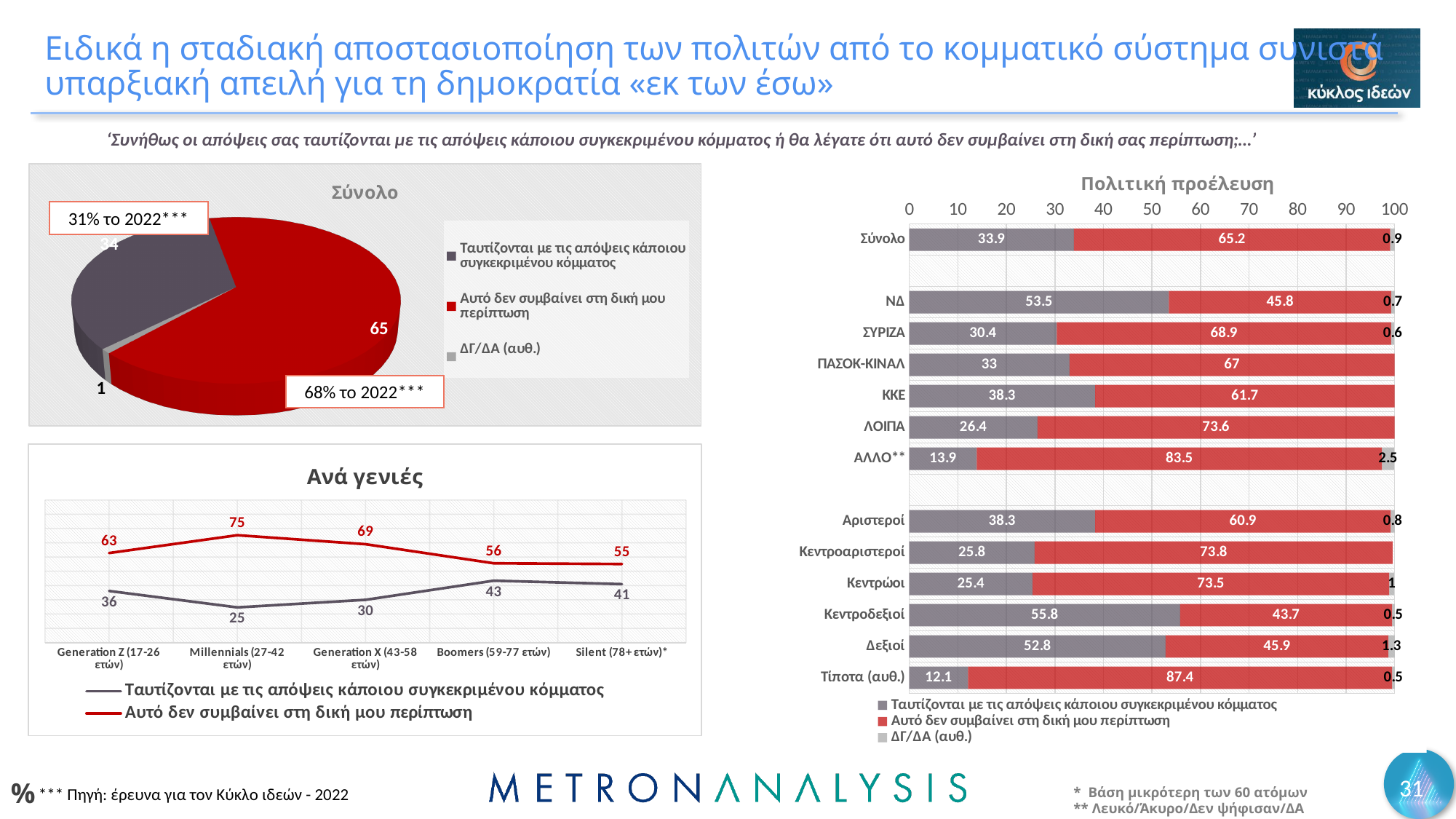
In the 'Ανά γενιές' chart, which generation has the lowest value for 'Ταυτίζονται με τις απόψεις κάποιου συγκεκριμένου κόμματος'? Millennials (27-42 ετών) What kind of chart is the 'Σύνολο' chart? pie chart How many series does the legend of the 'Πολιτική προέλευση' chart list? 3 In the 'Πολιτική προέλευση' chart, what is the value of 'Ταυτίζονται με τις απόψεις κάποιου συγκεκριμένου κόμματος' for ΝΔ? 53.5 What kind of chart is the 'Πολιτική προέλευση' chart? stacked bar chart In the 'Πολιτική προέλευση' chart, which is larger for ΚΚΕ: 'Ταυτίζονται με τις απόψεις κάποιου συγκεκριμένου κόμματος' or 'Αυτό δεν συμβαίνει στη δική μου περίπτωση'? Αυτό δεν συμβαίνει στη δική μου περίπτωση How many generation categories are shown on the x axis of the 'Ανά γενιές' chart? 5 In the 'Ανά γενιές' chart, what is the difference between the two series for Generation Z (17-26 ετών)? 27 In the 'Σύνολο' pie chart, what share is shown for 'Αυτό δεν συμβαίνει στη δική μου περίπτωση'? 65 In the 'Ανά γενιές' chart, what is the value of 'Αυτό δεν συμβαίνει στη δική μου περίπτωση' for Millennials (27-42 ετών)? 75 In the 'Πολιτική προέλευση' chart, which category has the highest value for 'Αυτό δεν συμβαίνει στη δική μου περίπτωση'? Τίποτα (αυθ.) In the 'Ανά γενιές' chart, does the red line 'Αυτό δεν συμβαίνει στη δική μου περίπτωση' rise or fall from Generation X (43-58 ετών) to Silent (78+ ετών)*? fall